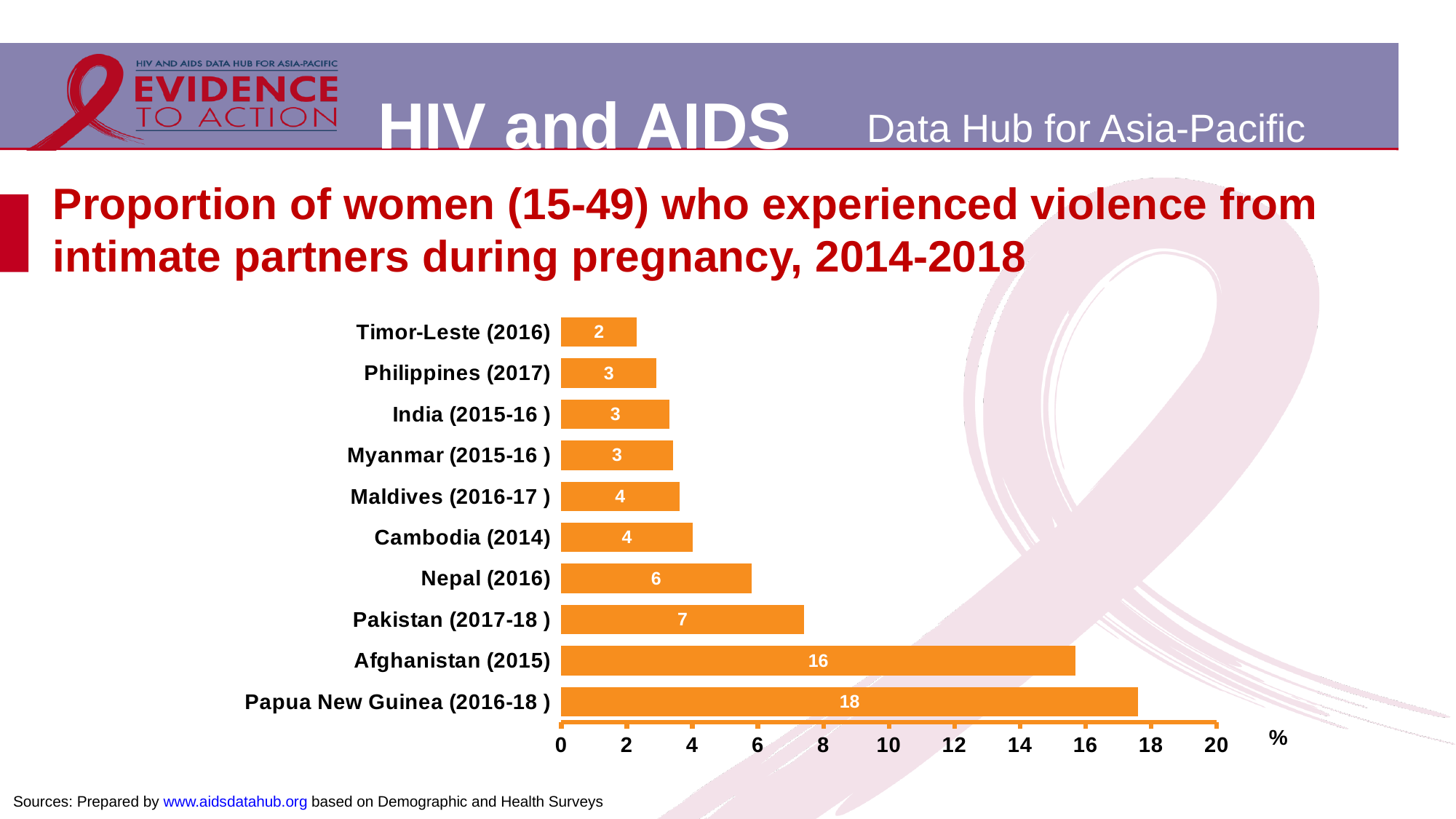
What kind of chart is shown on the slide? Bar chart What is the difference between the values for Pakistan (2017-18) and Nepal (2016)? 1 What is the value for Papua New Guinea (2016-18)? 18 Which is larger, the value for Pakistan (2017-18) or the value for Cambodia (2014)? Pakistan (2017-18) Which country has the lowest proportion? Timor-Leste (2016) What is the value for Timor-Leste (2016)? 2 What is the difference between the values for Papua New Guinea (2016-18) and Afghanistan (2015)? 2 Which country has the highest proportion? Papua New Guinea (2016-18) What is the value for Nepal (2016)? 6 What is the value for Afghanistan (2015)? 16 How many countries are shown in the chart? 10 Is the value for Afghanistan (2015) greater or less than 10? greater